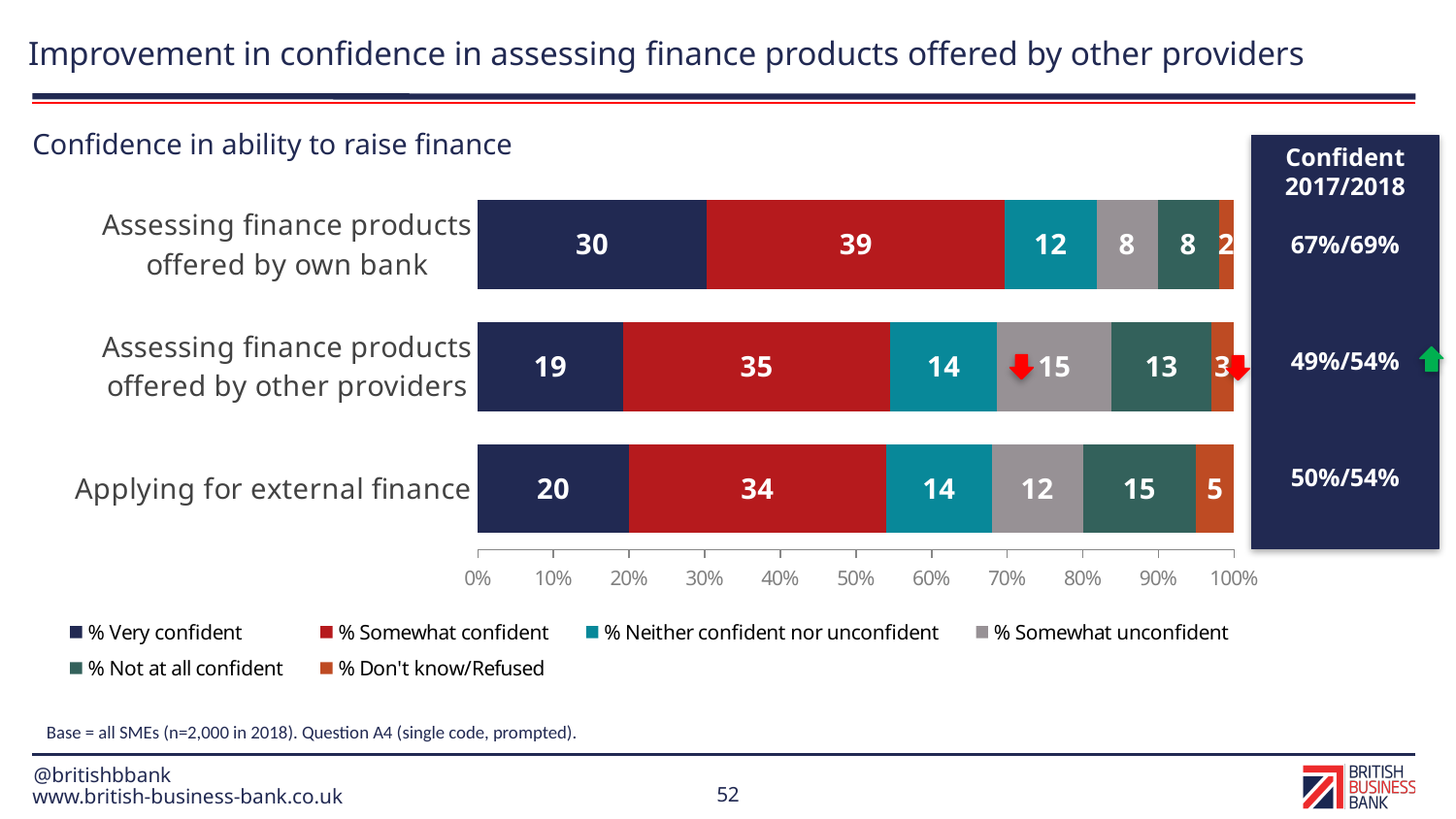
What is the total of the stacked bar for 'Assessing finance products offered by own bank'? 99 What kind of chart is shown on the slide? Stacked bar chart What is the % Somewhat confident value for 'Assessing finance products offered by other providers'? 35 What is the title of the chart? Confidence in ability to raise finance Which is larger: the % Somewhat unconfident value for 'Assessing finance products offered by other providers' or for 'Applying for external finance'? Assessing finance products offered by other providers What is the difference between the % Somewhat confident values for 'Assessing finance products offered by own bank' and 'Applying for external finance'? 5 What is the % Very confident value for 'Assessing finance products offered by own bank'? 30 Which category has the lowest % Not at all confident value? Assessing finance products offered by own bank What is the % Don't know/Refused value for 'Applying for external finance'? 5 How many categories are plotted on the chart? 3 Which category has the highest % Very confident value? Assessing finance products offered by own bank How many series does the legend list? 6